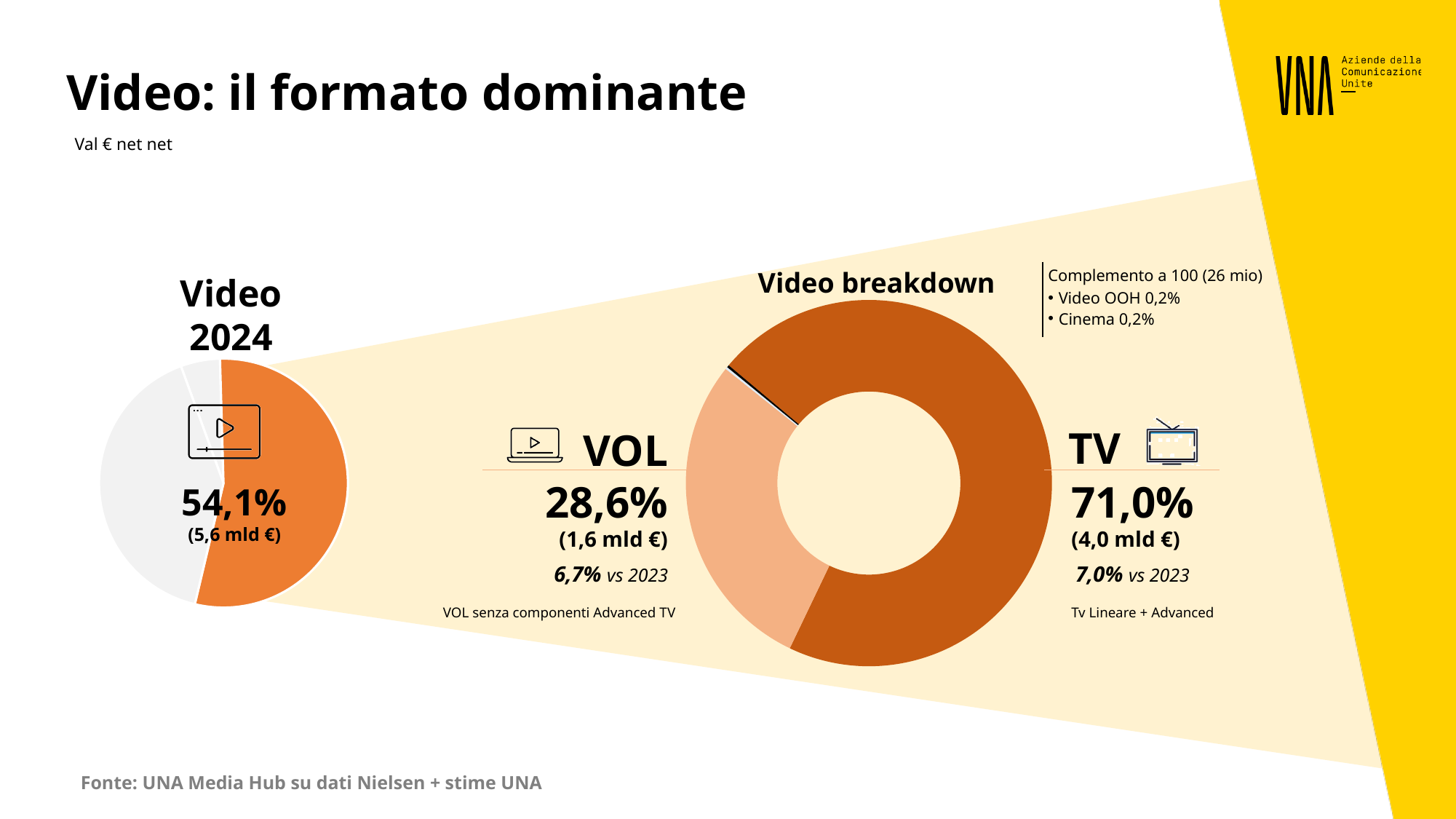
In the 'Video breakdown' donut chart, what value in euros is shown for TV? 4,0 mld € In the 'Video breakdown' donut chart, which is larger, TV or VOL? TV In the 'Video breakdown' donut chart, what value in euros is shown for VOL? 1,6 mld € In the 'Video breakdown' donut chart, which segment is the largest? TV In the 'Video breakdown' donut chart, what is the growth of VOL vs 2023? 6,7% In the 'Video breakdown' donut chart, what share does TV hold? 71,0% In the 'Video 2024' pie chart on the left, what share does Video hold? 54,1% In the 'Video breakdown' donut chart, what share does VOL hold? 28,6% What kind of chart is the 'Video breakdown' chart? Donut chart In the 'Video breakdown' donut chart, what is the difference in percentage points between TV and VOL? 42,4 In the 'Video 2024' pie chart on the left, what value in euros is shown for Video? 5,6 mld € In the 'Video breakdown' donut chart, what is the growth of TV vs 2023? 7,0%